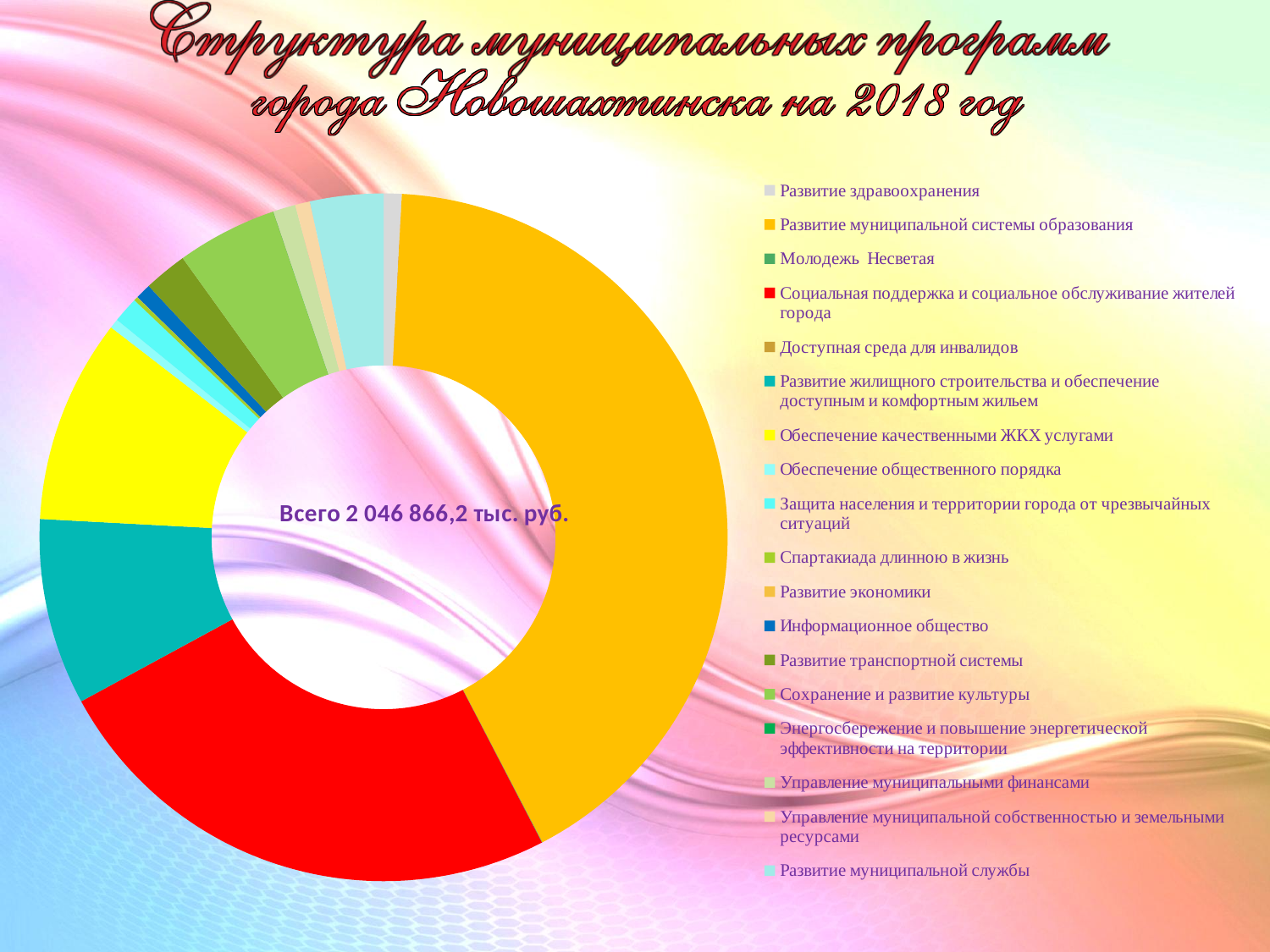
Which slice is larger: Социальная поддержка и социальное обслуживание жителей города or Обеспечение качественными ЖКХ услугами? Социальная поддержка и социальное обслуживание жителей города What total amount is printed in the centre of the chart? Всего 2 046 866,2 тыс. руб. What is the title of the slide containing the chart? Структура муниципальных программ города Новошахтинска на 2018 год How many programmes does the legend of the chart list? 18 Which slice is larger: Развитие муниципальной системы образования or Социальная поддержка и социальное обслуживание жителей города? Развитие муниципальной системы образования Which programme is shown in red in the chart? Социальная поддержка и социальное обслуживание жителей города Which slice is larger: Социальная поддержка и социальное обслуживание жителей города or Развитие жилищного строительства и обеспечение доступным и комфортным жильем? Социальная поддержка и социальное обслуживание жителей города Which programme has the largest slice in the chart? Развитие муниципальной системы образования What kind of chart is shown on the slide? doughnut chart